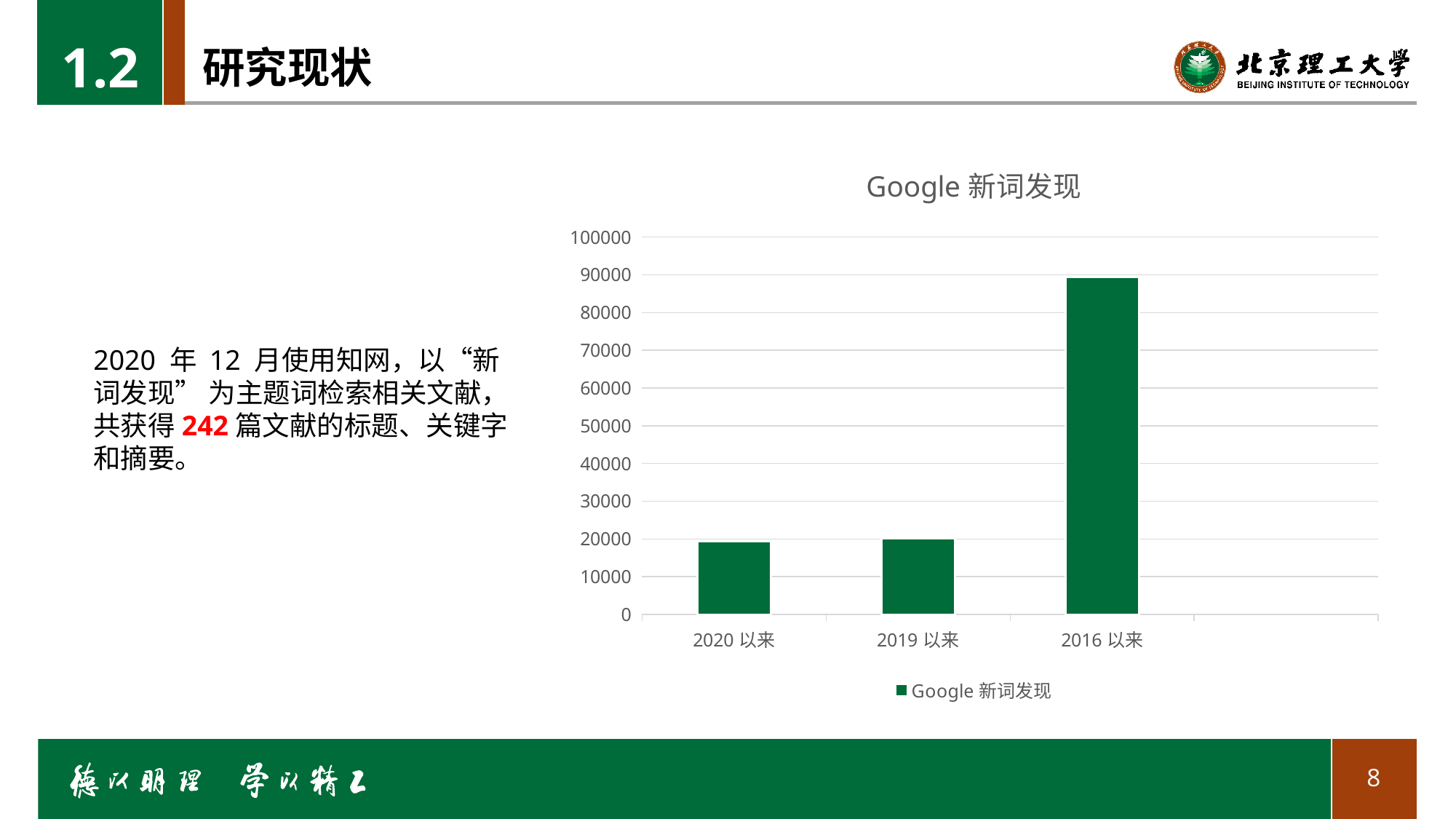
How many categories are shown on the x axis of the chart? 3 What is the name of the series listed in the legend? Google 新词发现 Is the value for 2016 以来 greater or less than 80000? greater Do the values rise or fall moving from left to right along the x axis? rise What is the title of the chart? Google 新词发现 Is the value for 2019 以来 greater or less than 30000? less What kind of chart is shown on the slide? bar chart How many series does the chart's legend list? 1 Is the value for 2016 以来 greater or less than 50000? greater Which is larger, the value for 2016 以来 or the value for 2020 以来? 2016 以来 Which category has the highest value in the chart? 2016 以来